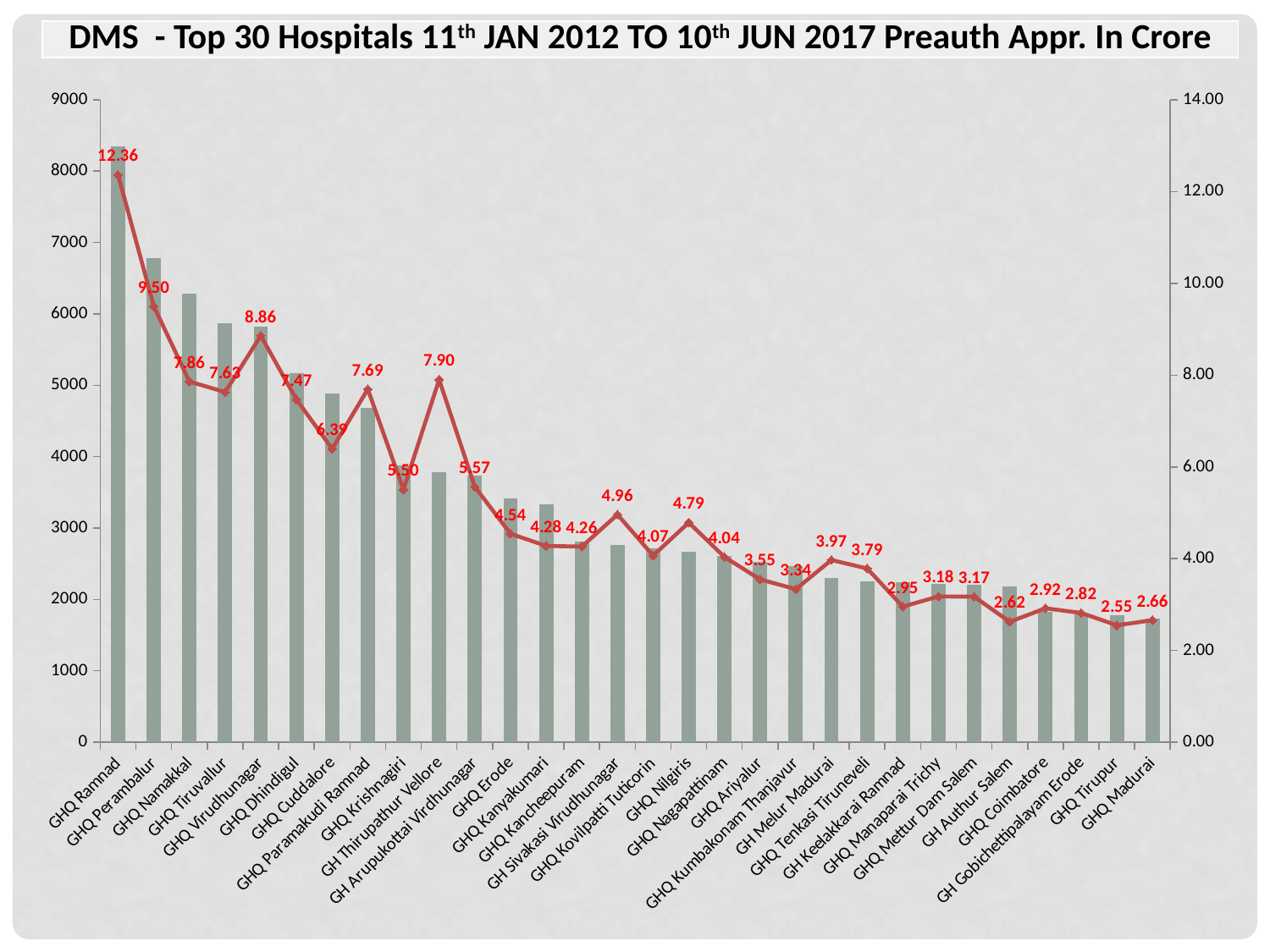
Is the bar value for GHQ Madurai on the left axis greater or less than 2000? less Do the line values in crore generally rise or fall from left to right across the hospitals? Fall Which has the larger line value in crore, GHQ Virudhunagar or GHQ Cuddalore? GHQ Virudhunagar How many hospitals are shown on the x axis of the chart? 30 What is the preauth approval value in crore shown for GH Thirupathur Vellore? 7.90 What is the preauth approval value in crore shown for GHQ Nilgiris? 4.79 What is the difference in crore between the line values for GHQ Ramnad and GHQ Perambalur? 2.86 Is the bar value for GHQ Ramnad on the left axis greater or less than 8000? greater What is the preauth approval value in crore shown for GHQ Ramnad? 12.36 Which hospital has the lowest preauth approval value in crore on the line? GHQ Tirupur What kind of chart is shown on the slide? Combined bar and line chart Which hospital has the highest preauth approval value in crore on the line? GHQ Ramnad